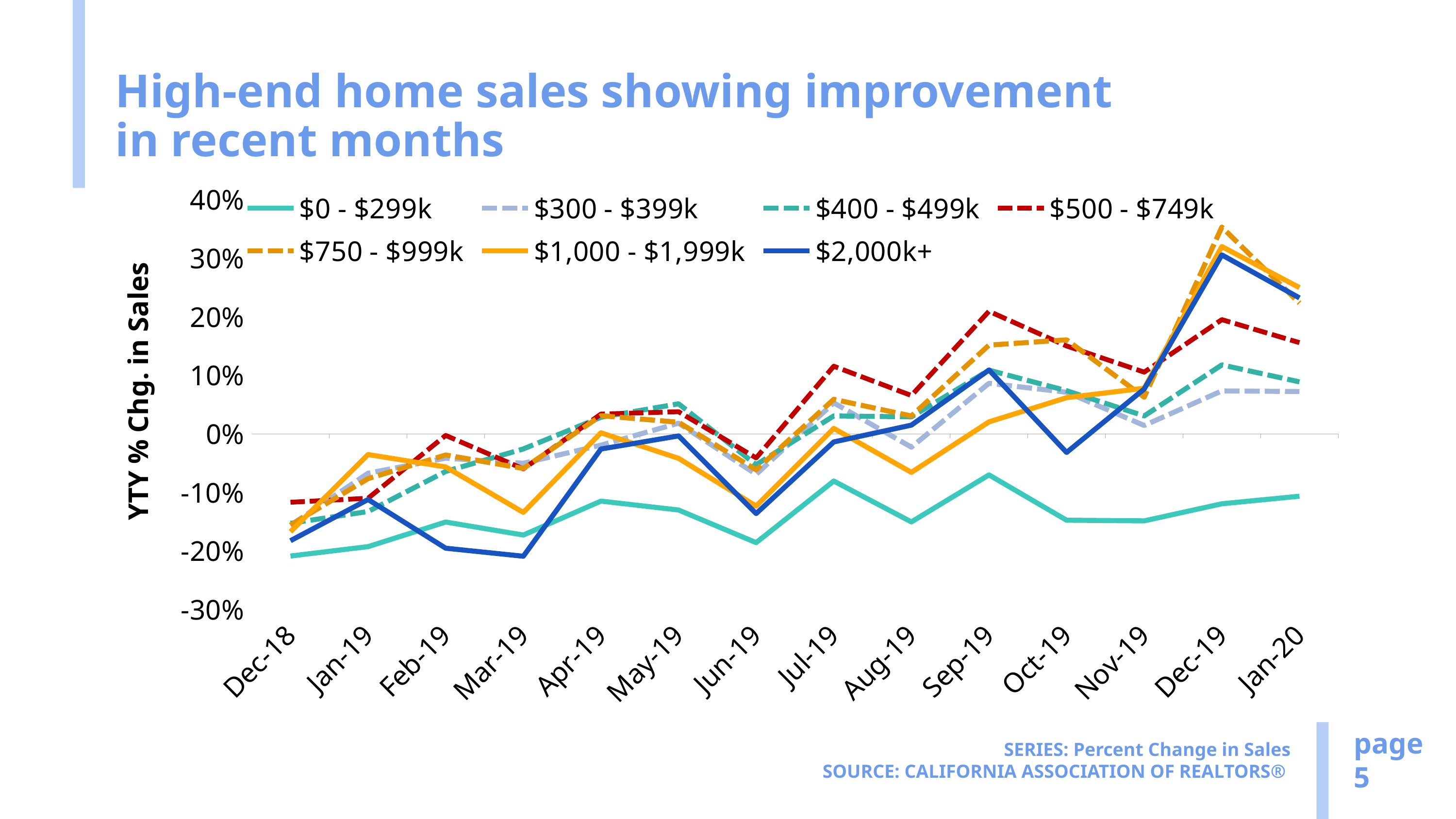
What is the label on the y axis? YTY % Chg. in Sales How many months are shown along the x axis? 14 What kind of chart is shown on the slide? line chart Is the value for $500 - $749k in Sep-19 greater or less than 10%? greater How many series does the legend list? 7 Is the value for $0 - $299k in Dec-18 greater or less than -10%? less In Oct-19, which is larger: the value for $2,000k+ or the value for $500 - $749k? $500 - $749k Is the value for $750 - $999k in Dec-19 greater or less than 30%? greater In Jan-20, which is larger: the value for $0 - $299k or the value for $2,000k+? $2,000k+ Does the $0 - $299k series rise or fall overall from Dec-18 to Jan-20? rise Which series has the lowest value in Jan-20? $0 - $299k